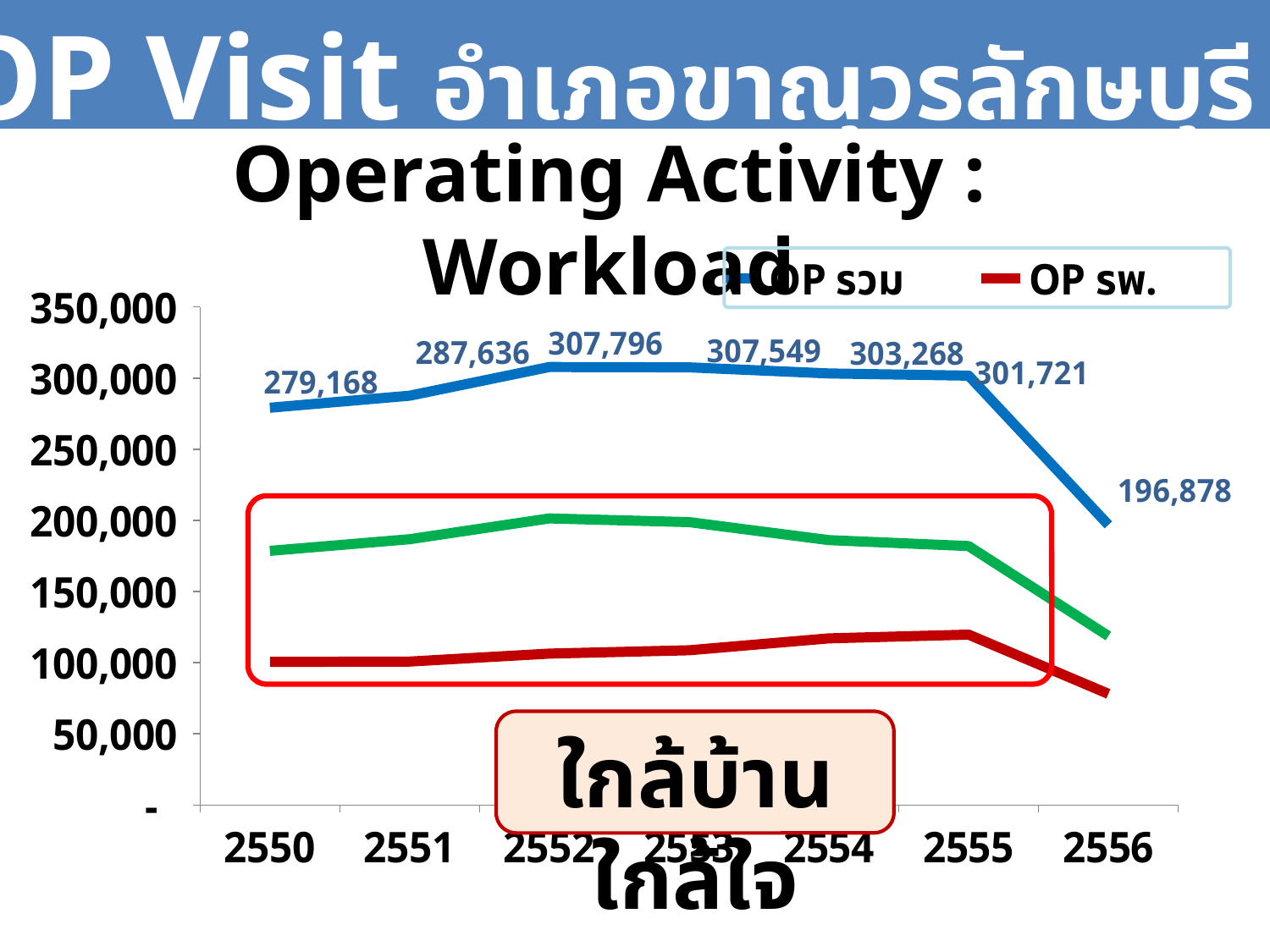
What is the value of OP รวม in 2554? 303,268 By how much did OP รวม fall from 2555 to 2556? 104,843 What is the value of OP รวม in 2556? 196,878 Which is larger, OP รวม in 2551 or in 2555? 2555 Is the value of OP รพ. in 2556 greater or less than 100,000? less What is the value of OP รวม in 2550? 279,168 How many years are shown on the x axis? 7 In which year is OP รวม highest? 2552 In which year is OP รวม lowest? 2556 What type of chart is shown on the slide? line chart Is the value of the green line in 2550 greater or less than 150,000? greater What is the difference between OP รวม in 2552 and in 2550? 28,628